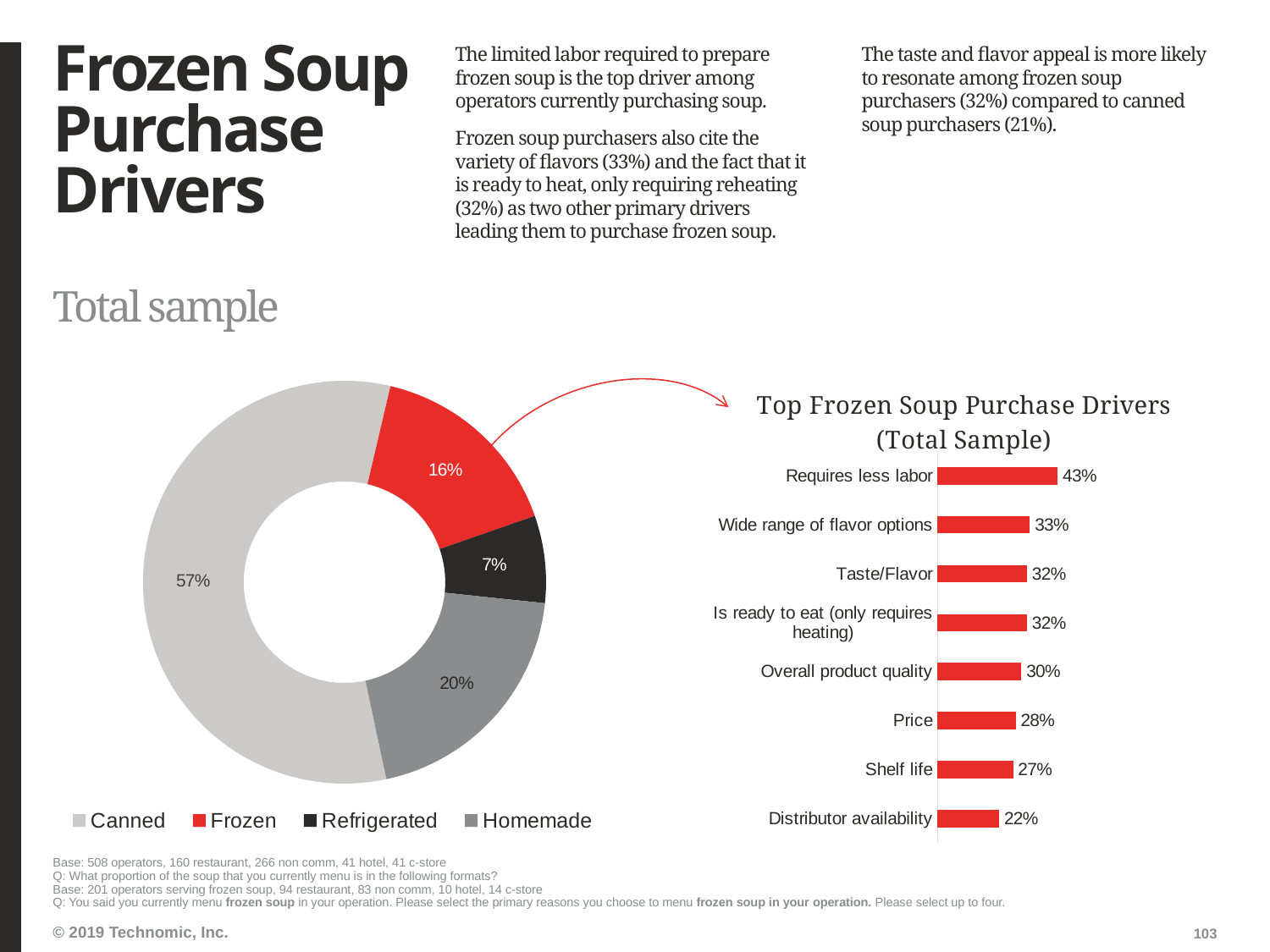
In the 'Top Frozen Soup Purchase Drivers (Total Sample)' chart, what is the difference between Requires less labor and Price? 15% What kind of chart is the 'Top Frozen Soup Purchase Drivers (Total Sample)' chart? Bar chart In the donut chart on the left, what is the difference between the Homemade and Frozen shares? 4% In the 'Top Frozen Soup Purchase Drivers (Total Sample)' chart, what is the value for Requires less labor? 43% In the donut chart on the left, which format has the smallest share? Refrigerated In the donut chart on the left, what share is Frozen? 16% In the 'Top Frozen Soup Purchase Drivers (Total Sample)' chart, which is larger: Overall product quality or Shelf life? Overall product quality In the donut chart on the left, what share of the total sample is Canned? 57% In the 'Top Frozen Soup Purchase Drivers (Total Sample)' chart, how many drivers are shown? 8 In the 'Top Frozen Soup Purchase Drivers (Total Sample)' chart, what is the value for Shelf life? 27% In the donut chart on the left, how many formats does the legend list? 4 In the 'Top Frozen Soup Purchase Drivers (Total Sample)' chart, which driver has the lowest value? Distributor availability